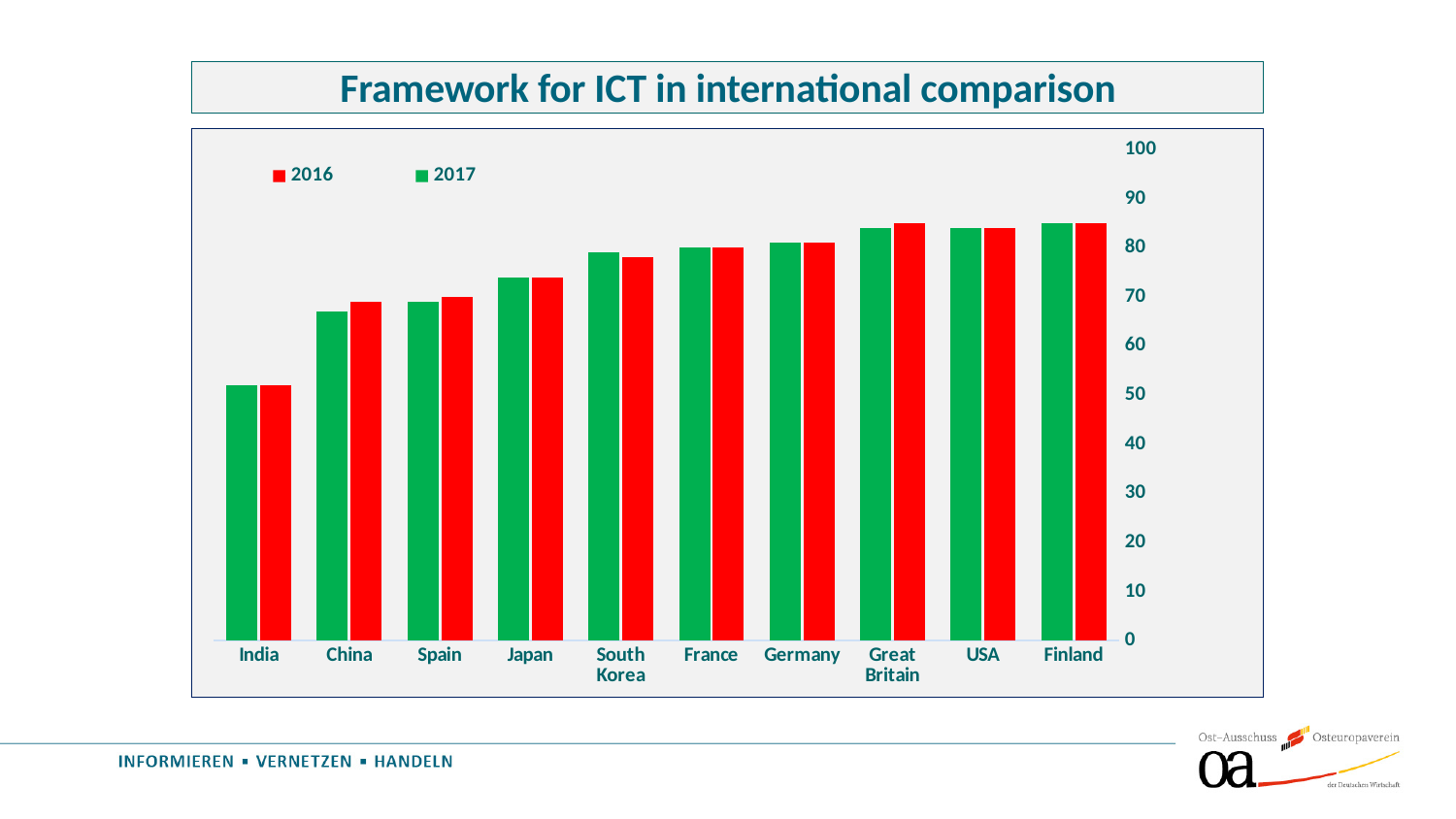
Which colour represents the 2016 series in the chart? red What is the title of the chart? Framework for ICT in international comparison Is the 2017 value for Japan greater or less than 70? greater How many series does the chart's legend list? 2 Is the 2016 value for South Korea greater or less than 70? greater Which has the larger 2017 value, China or Japan? Japan Is the 2016 value for Finland greater or less than 80? greater Do the values generally rise or fall moving from India on the left to Finland on the right? rise How many countries are shown on the x axis of the chart? 10 What kind of chart is shown on the slide? bar chart Which country has the lowest value in the chart? India